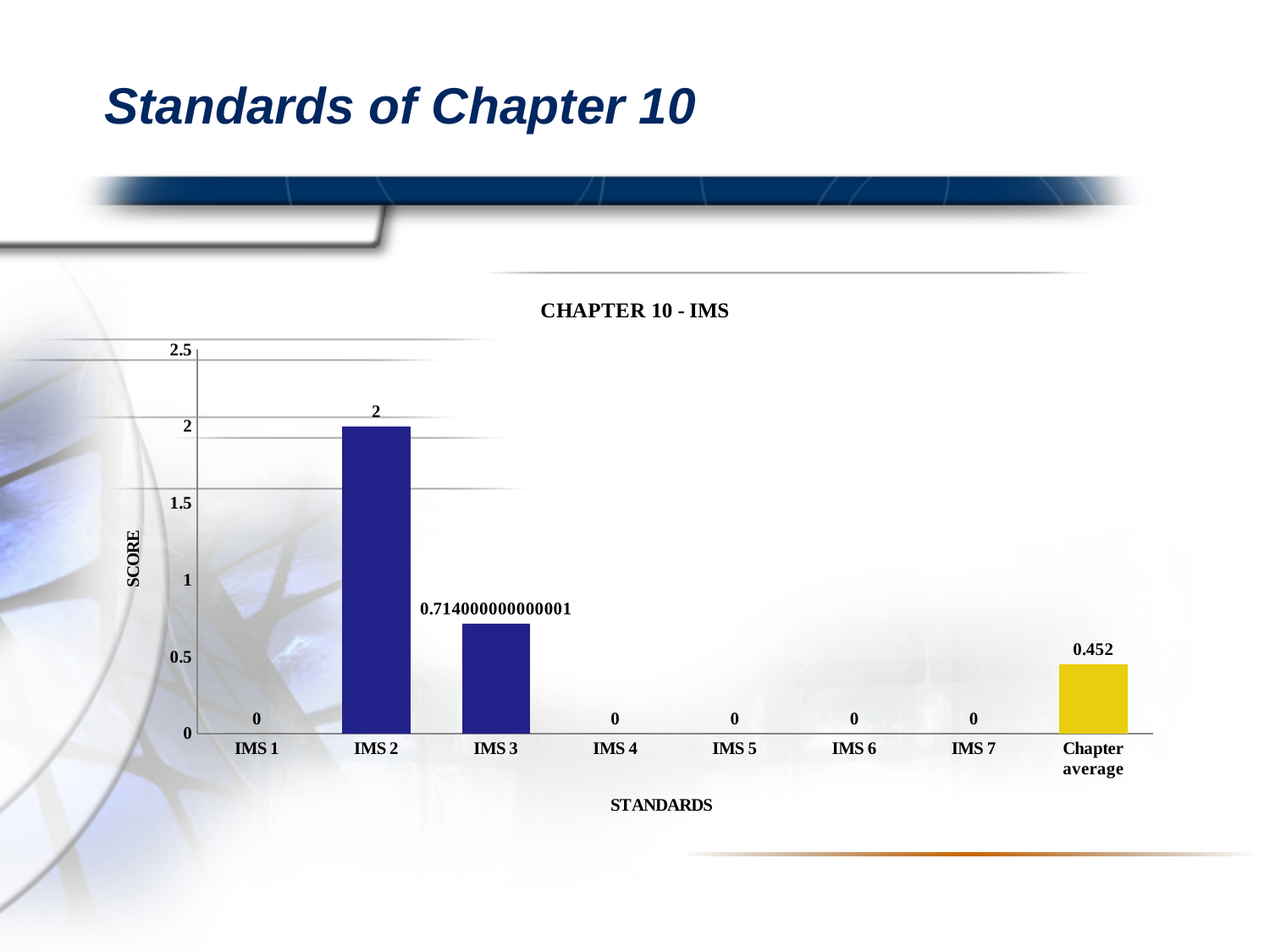
Which standard has the highest score? IMS 2 How many categories are shown on the x axis? 8 What is the score for IMS 2? 2 What is the title of the chart? CHAPTER 10 - IMS What is the difference between the score for IMS 2 and the Chapter average? 1.548 What is the score for IMS 5? 0 What type of chart is shown? bar chart Which is larger, the score for IMS 3 or the Chapter average? IMS 3 Is the value for IMS 3 greater or less than 1? less How many of the IMS standards have a score of 0? 5 What is the data label on the IMS 3 bar? 0.714000000000001 What value is shown for the Chapter average bar? 0.452